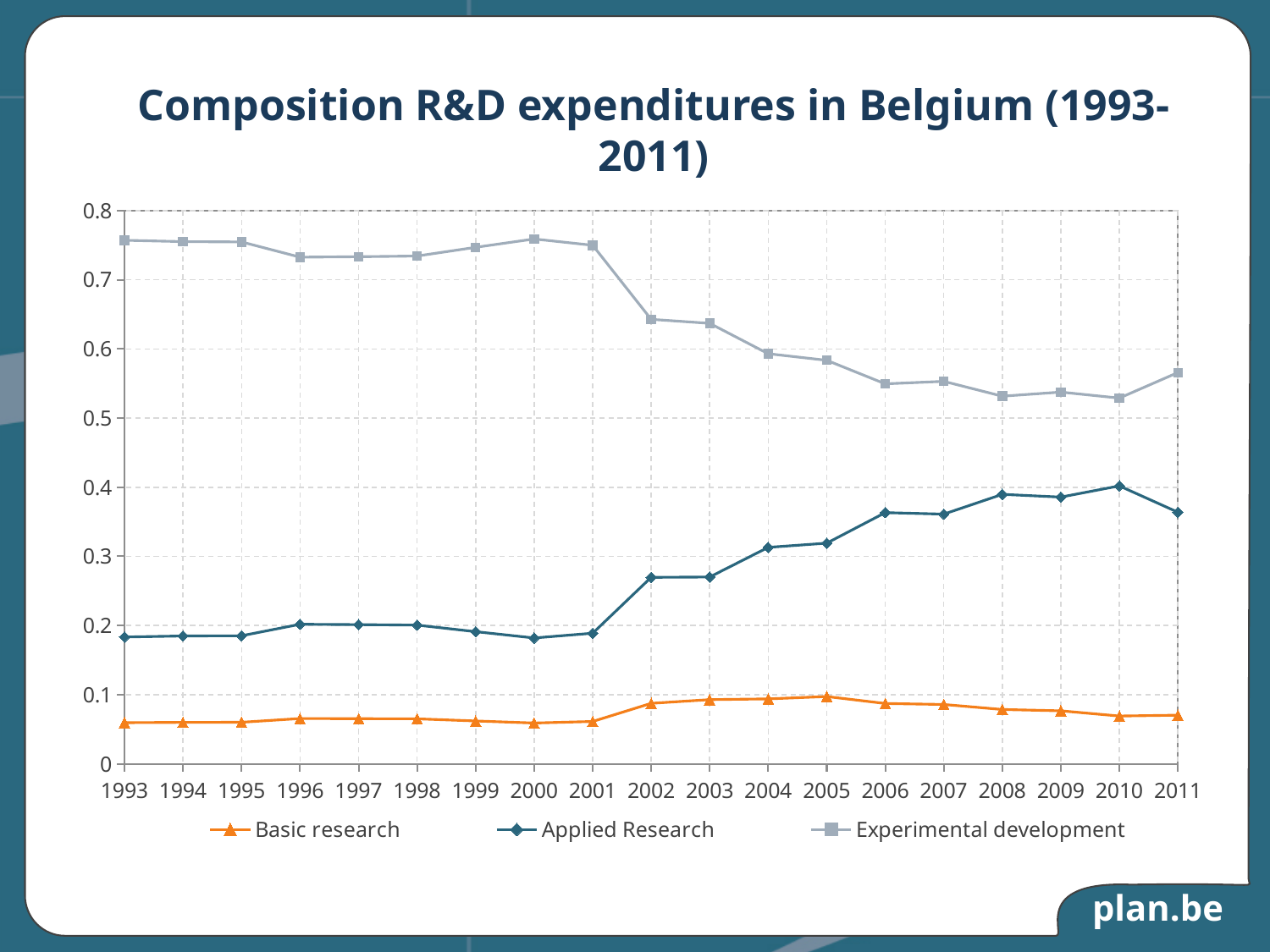
Is the value for Experimental development in 2011 greater or less than 0.6? less What is the title of the chart? Composition R&D expenditures in Belgium (1993-2011) Does the Applied Research series rise or fall between 2001 and 2010? rise Is the value for Applied Research in 2002 greater or less than 0.2? greater How many series does the legend list? 3 Is the value for Basic research in 1993 greater or less than 0.1? less Which series has the highest value in 2011? Experimental development What kind of chart is shown on the slide? Line chart How many years are plotted along the x axis? 19 Is the Experimental development value larger in 2001 or in 2002? 2001 Which series has the lowest value in 1993? Basic research